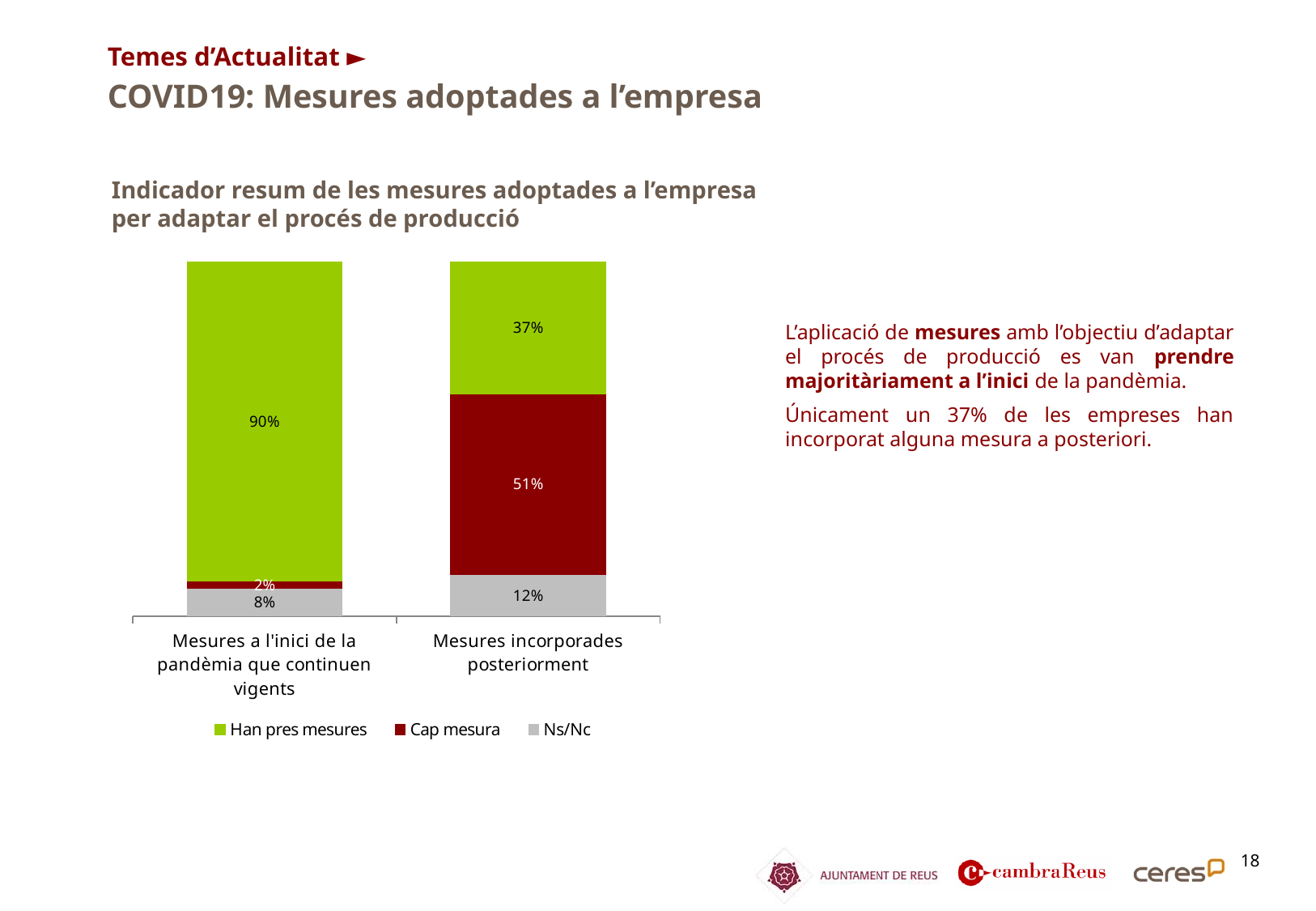
What is the value of 'Han pres mesures' for 'Mesures a l'inici de la pandèmia que continuen vigents'? 90% How many categories are shown on the x axis of the chart? 2 Which legend entry is shown in green? Han pres mesures What kind of chart is shown on the slide? Stacked bar chart How many series does the chart legend list? 3 What is the value of 'Han pres mesures' for 'Mesures incorporades posteriorment'? 37% What is the value of 'Cap mesura' for 'Mesures incorporades posteriorment'? 51% What is the value of 'Ns/Nc' for 'Mesures incorporades posteriorment'? 12% What is the difference between the 'Han pres mesures' values of the two categories? 53% Is the 'Cap mesura' value larger for 'Mesures a l'inici de la pandèmia que continuen vigents' or for 'Mesures incorporades posteriorment'? Mesures incorporades posteriorment What is the value of 'Ns/Nc' for 'Mesures a l'inici de la pandèmia que continuen vigents'? 8% Which category has the higher value for 'Han pres mesures'? Mesures a l'inici de la pandèmia que continuen vigents